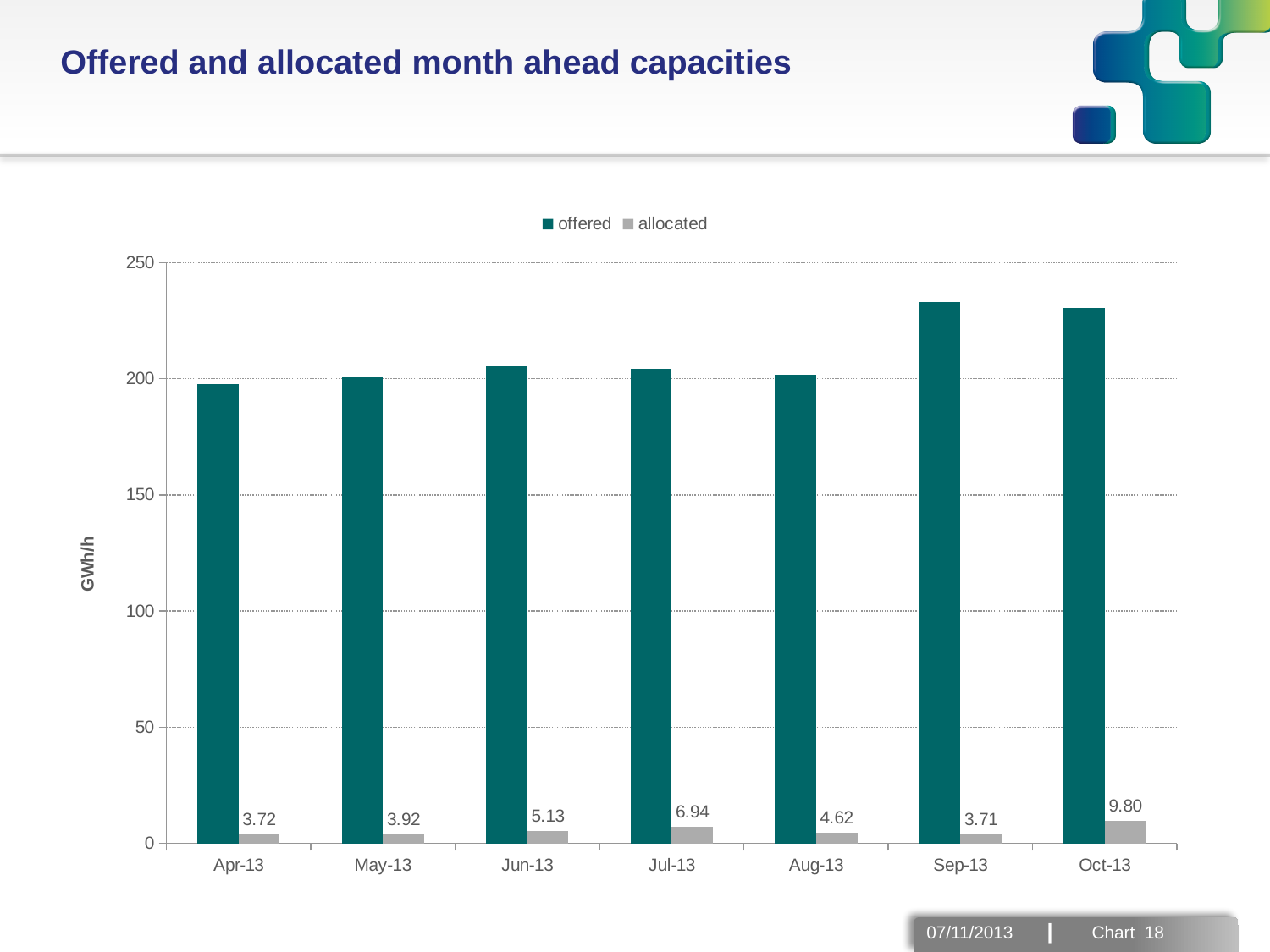
What is the allocated value for Oct-13? 9.80 How many months are shown on the x axis? 7 Is the offered value for Sep-13 greater or less than 200? greater Which is larger, the allocated value for Jun-13 or for Aug-13? Jun-13 What is the difference between the allocated values for Oct-13 and Apr-13? 6.08 What is the allocated value for Jul-13? 6.94 What kind of chart is shown on the slide? bar chart Is the offered value for Apr-13 greater or less than 200? less Which month has the highest allocated value? Oct-13 How many series does the legend list? 2 Which month has the lowest allocated value? Sep-13 What is the allocated value for Apr-13? 3.72